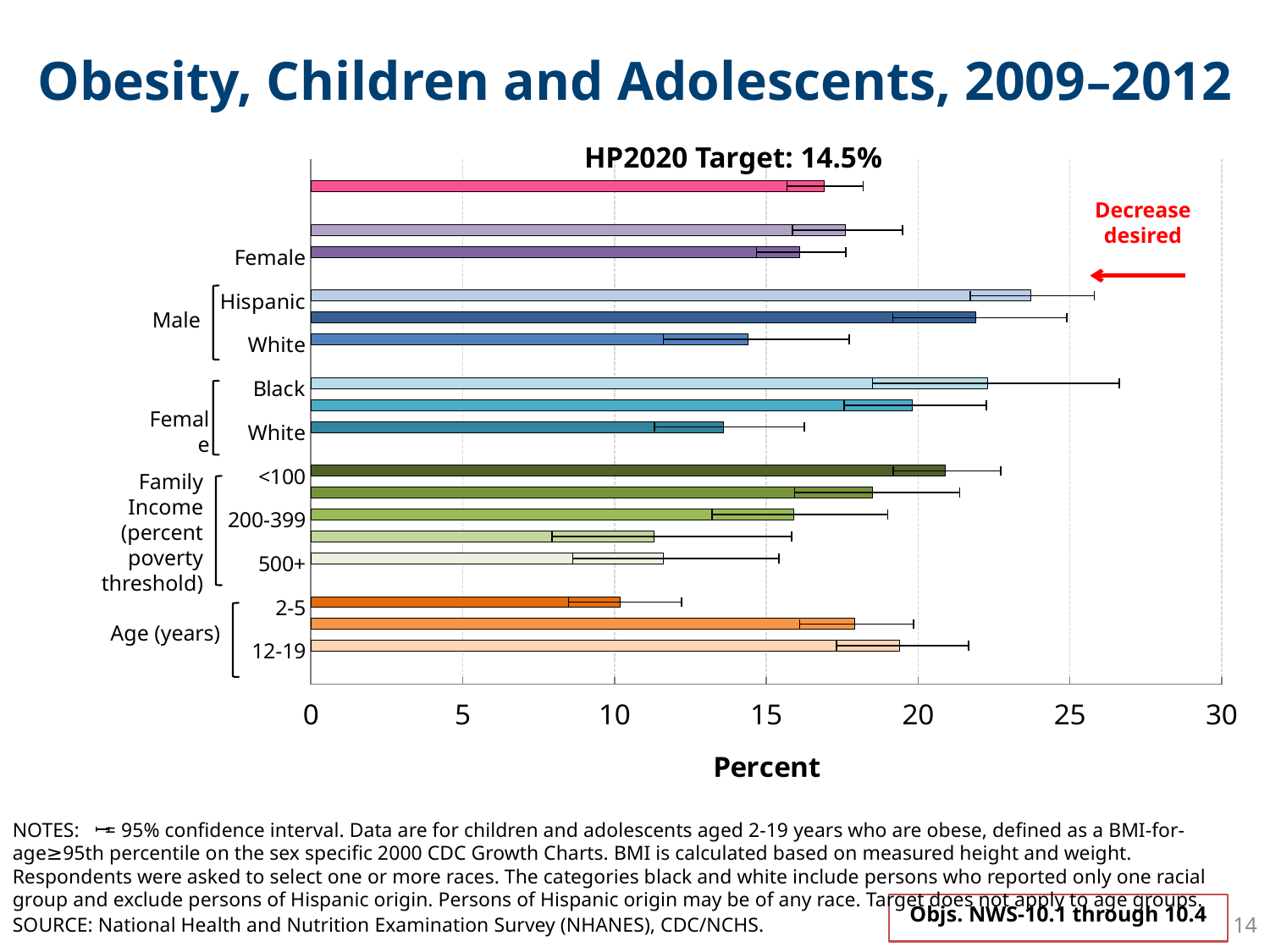
Which has the larger value, ages 2-5 or ages 12-19? 12-19 Is the value for Hispanic males greater or less than 20? greater What kind of chart is shown on the slide? bar chart What is the label of the horizontal axis? Percent Is the value for White females greater or less than 15? less Is the value for White males greater or less than 15? less What is the HP2020 target shown above the chart? 14.5% Which has the larger value, Hispanic males or White males? Hispanic males How many bars are shown in the Family Income group? 5